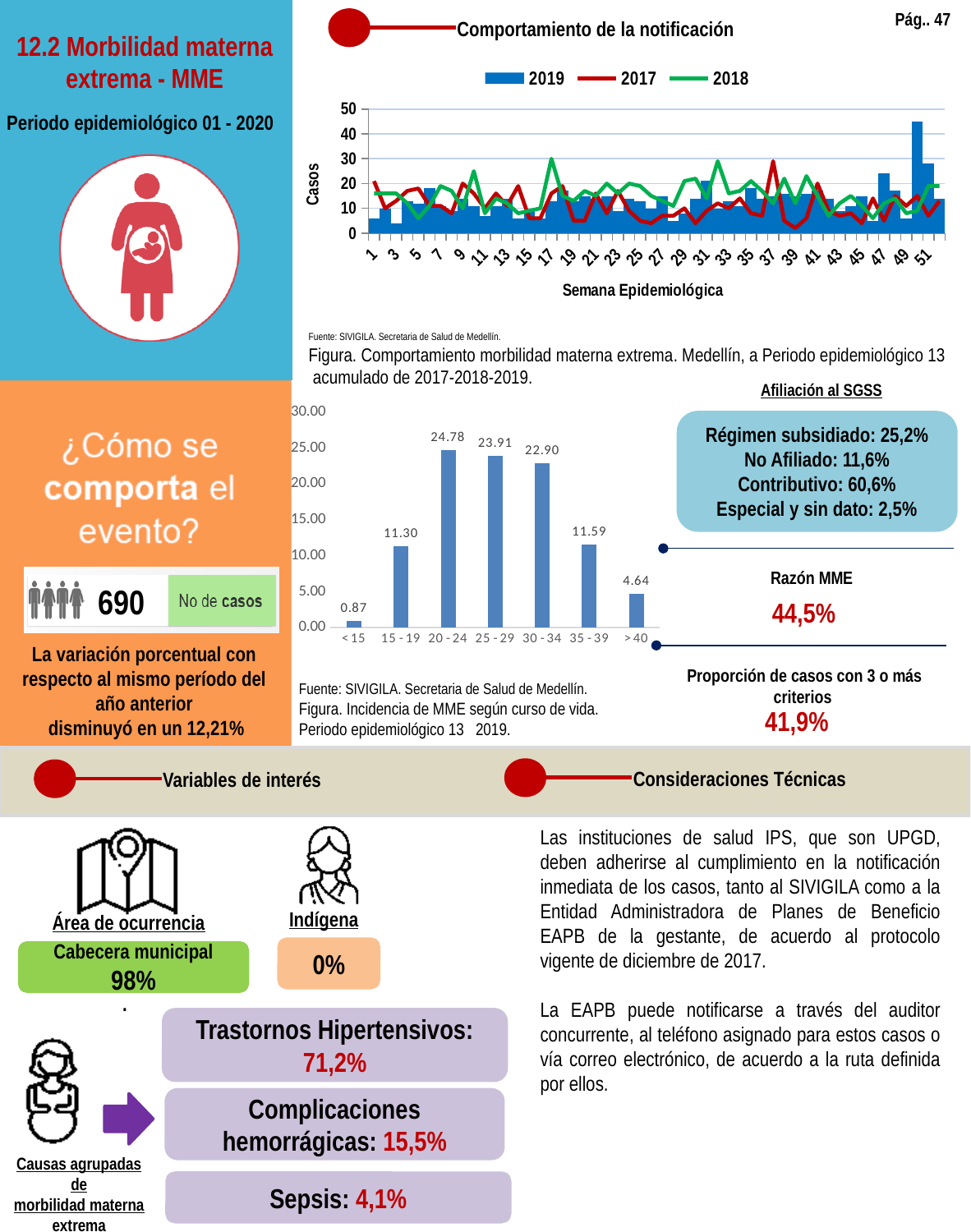
In the chart 'Incidencia de MME según curso de vida', what is the difference between the values for 20 - 24 and 25 - 29? 0.87 What kind of chart is 'Incidencia de MME según curso de vida'? Bar chart In the chart 'Incidencia de MME según curso de vida', what is the value for the > 40 age group? 4.64 In the chart 'Incidencia de MME según curso de vida', which has the larger value, 15 - 19 or 35 - 39? 35 - 39 In the chart 'Incidencia de MME según curso de vida', which age group has the highest value? 20 - 24 What is the x-axis title of the chart 'Comportamiento de la notificación'? Semana Epidemiológica How many age groups are shown in the chart 'Incidencia de MME según curso de vida'? 7 In the chart 'Incidencia de MME según curso de vida', which age group has the lowest value? < 15 In the chart 'Incidencia de MME según curso de vida', what is the value for the 20 - 24 age group? 24.78 How many series does the legend of the chart 'Comportamiento de la notificación' list? 3